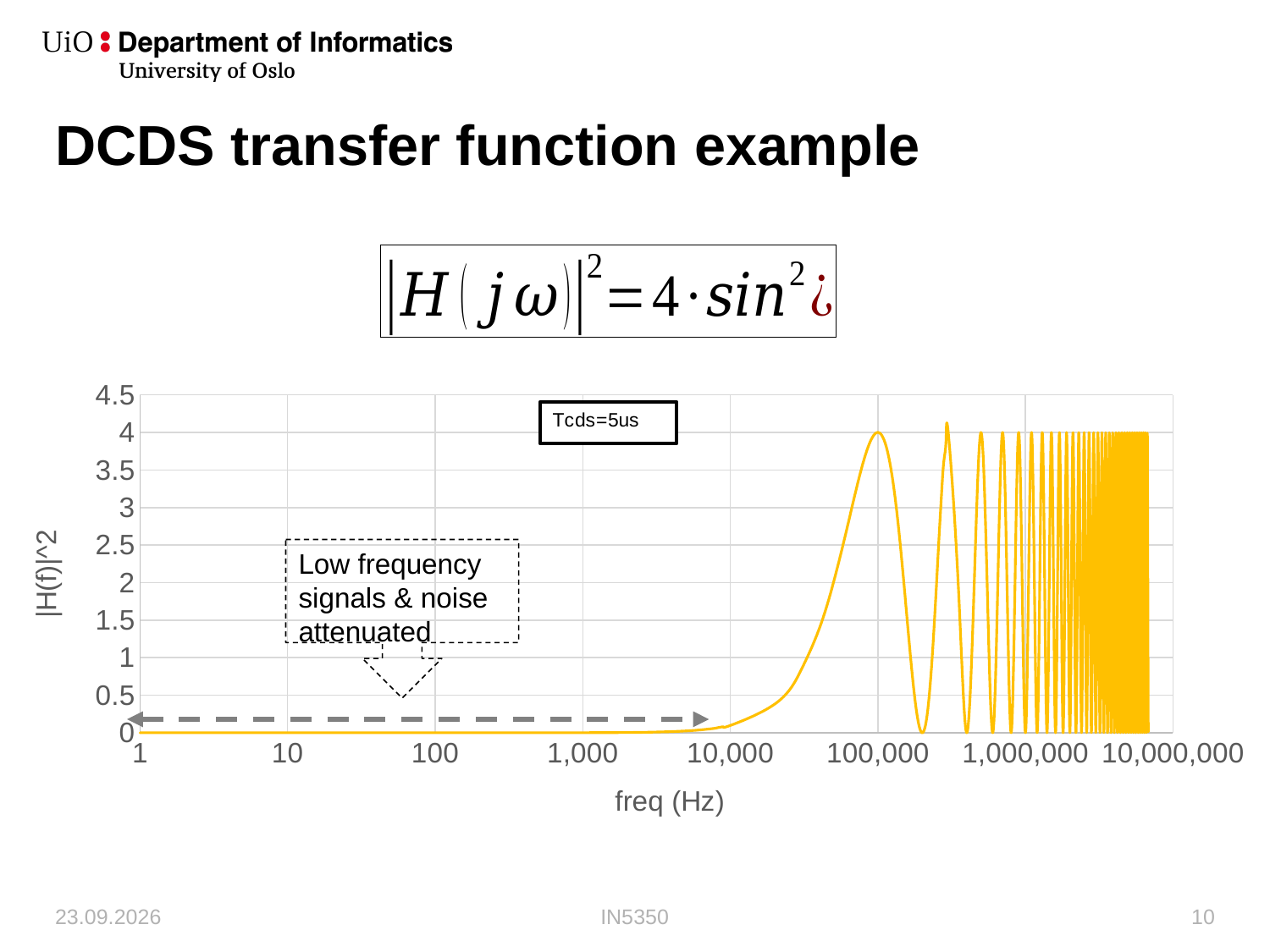
Is the value of |H(f)|^2 at 10 Hz greater or less than 2? less Is the peak value of |H(f)|^2 near 100,000 Hz greater or less than 3.5? greater How many labelled tick marks are on the frequency axis? 8 What value of Tcds is stated in the box on the chart? Tcds=5us Is the value of |H(f)|^2 at 1,000 Hz greater or less than 1? less What is the highest value labelled on the vertical axis? 4.5 What kind of chart is shown on the slide? line chart Does |H(f)|^2 rise or fall as the frequency increases from 10,000 Hz to 100,000 Hz? rise